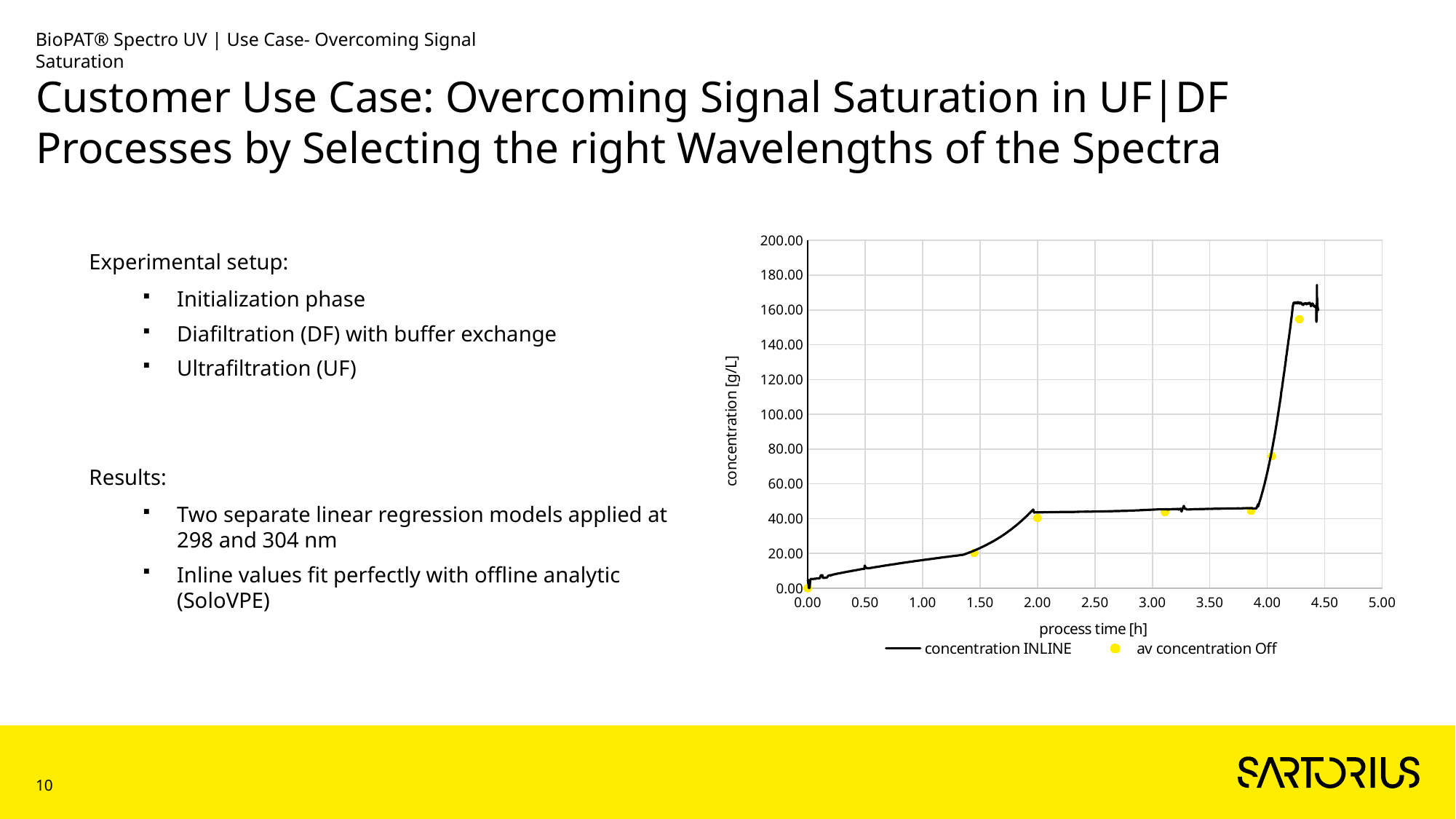
Is the concentration INLINE value at a process time of 3.00 h greater or less than 60? less Is the av concentration Off point near a process time of 1.50 h greater or less than 40? less Which is larger: the concentration INLINE value at 2.50 h or at 4.25 h? 4.25 h Is the av concentration Off point near a process time of 4.00 h greater or less than 60? greater What is the label of the y axis of the chart? concentration [g/L] What kind of chart is shown on the slide? line chart Does the concentration INLINE line generally rise or fall as process time increases? rise How many series does the chart legend list? 2 What are the two series named in the chart legend? concentration INLINE and av concentration Off